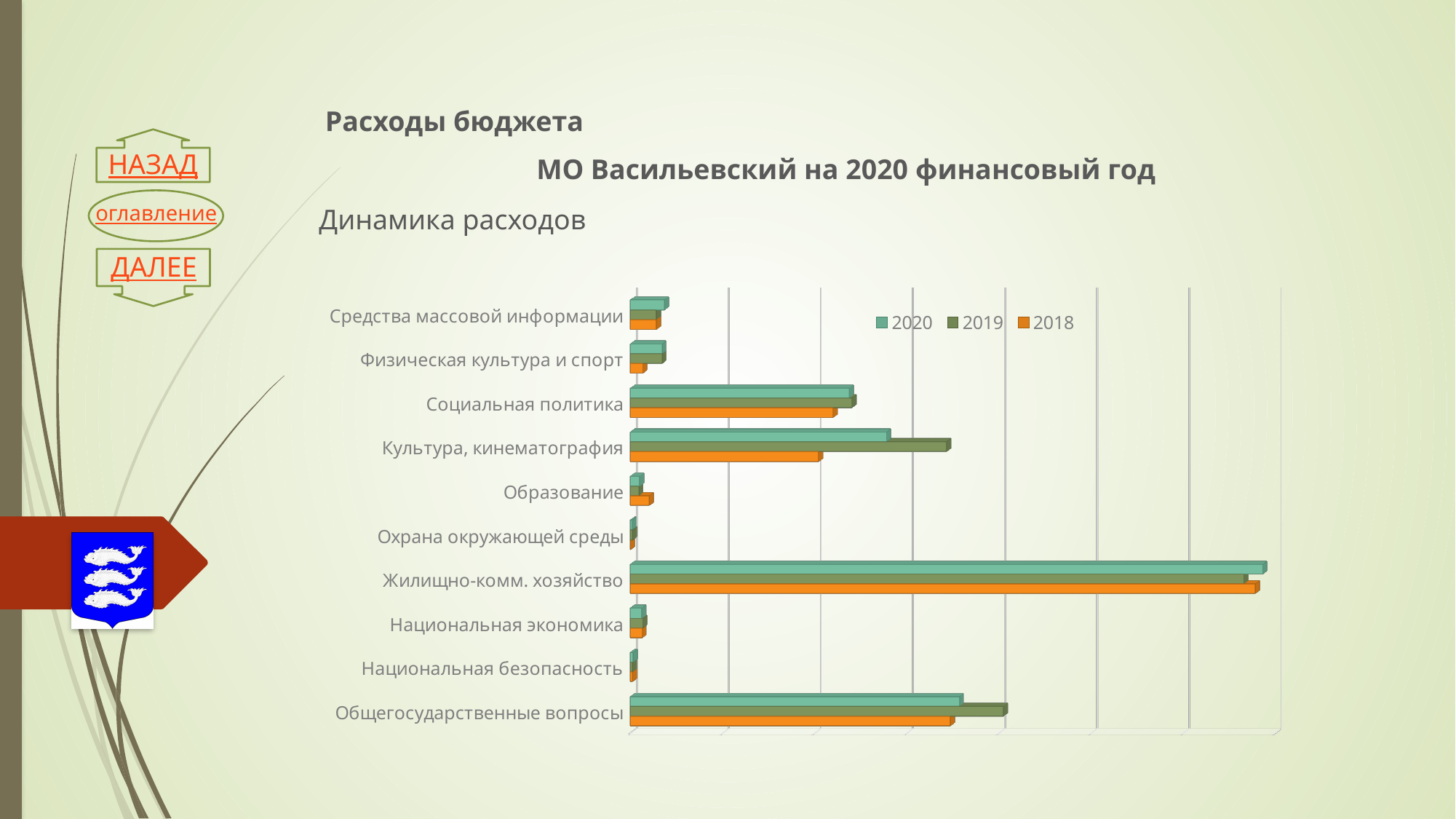
For 2020, which category has the larger value: Социальная политика or Общегосударственные вопросы? Общегосударственные вопросы For 2019, which category has the larger value: Социальная политика or Культура, кинематография? Культура, кинематография Which category has the highest value for 2020? Жилищно-комм. хозяйство For Образование, which year has the larger value: 2018 or 2020? 2018 Which years are listed in the chart legend? 2020, 2019, 2018 What kind of chart is shown on the slide? Bar chart How many series does the chart legend list? 3 How many categories are shown on the chart? 10 Which category has the highest value for 2018? Жилищно-комм. хозяйство What is the title shown above the chart? Динамика расходов